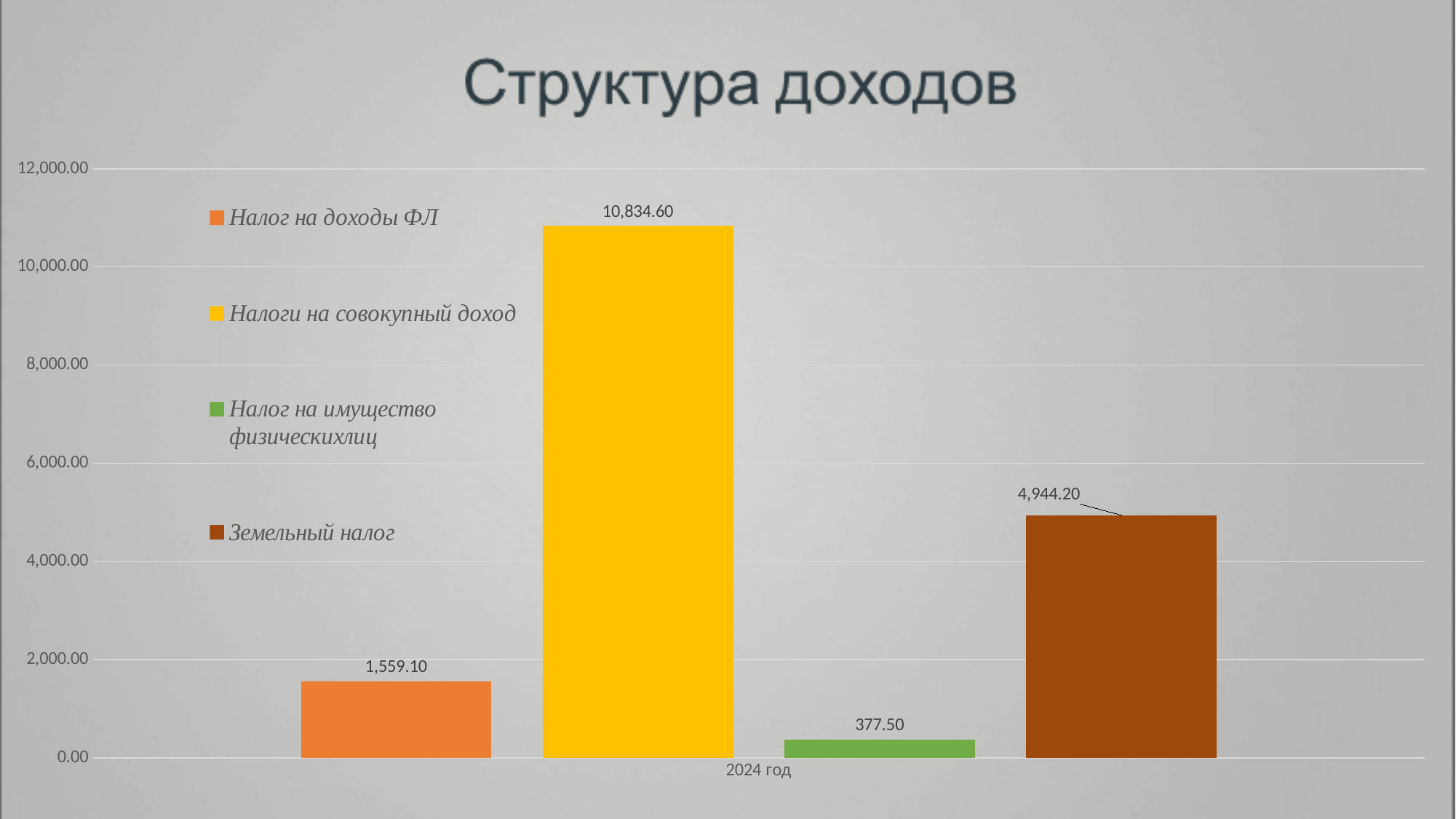
What is the value for Налог на имущество физическихлиц in 2024 год? 377.50 Which series has the lowest value in 2024 год? Налог на имущество физическихлиц How many series does the legend list? 4 Is the value for Налоги на совокупный доход greater or less than 10,000.00? greater What is the difference between Налоги на совокупный доход and Земельный налог? 5,890.40 Which is larger, Земельный налог or Налог на доходы ФЛ? Земельный налог What is the value for Налог на доходы ФЛ in 2024 год? 1,559.10 Which series has the highest value in 2024 год? Налоги на совокупный доход What kind of chart is shown on the slide? bar chart What is the difference between Земельный налог and Налог на доходы ФЛ? 3,385.10 What is the value for Налоги на совокупный доход in 2024 год? 10,834.60 What is the value for Земельный налог in 2024 год? 4,944.20